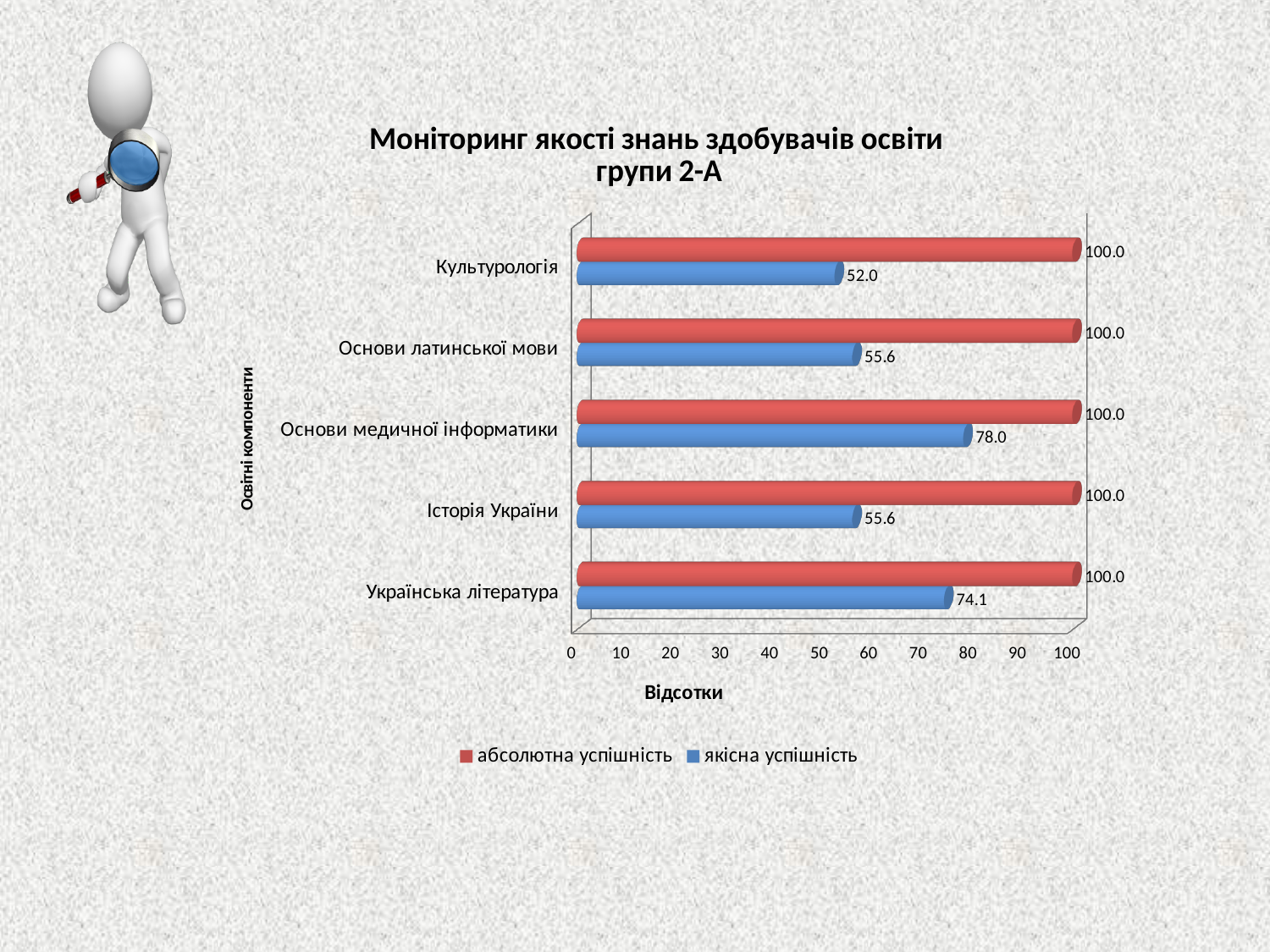
What is the якісна успішність value for Культурологія? 52.0 Which category has the highest якісна успішність value? Основи медичної інформатики What is the difference between the абсолютна успішність and якісна успішність values for Культурологія? 48.0 Which category has the lowest якісна успішність value? Культурологія What is the difference in якісна успішність between Основи медичної інформатики and Українська література? 3.9 What is the абсолютна успішність value for Історія України? 100.0 How many series does the legend list? 2 Which has a larger якісна успішність value, Основи латинської мови or Українська література? Українська література What is the якісна успішність value for Українська література? 74.1 How many categories are shown on the chart? 5 What is the якісна успішність value for Основи медичної інформатики? 78.0 What kind of chart is shown on the slide? Bar chart